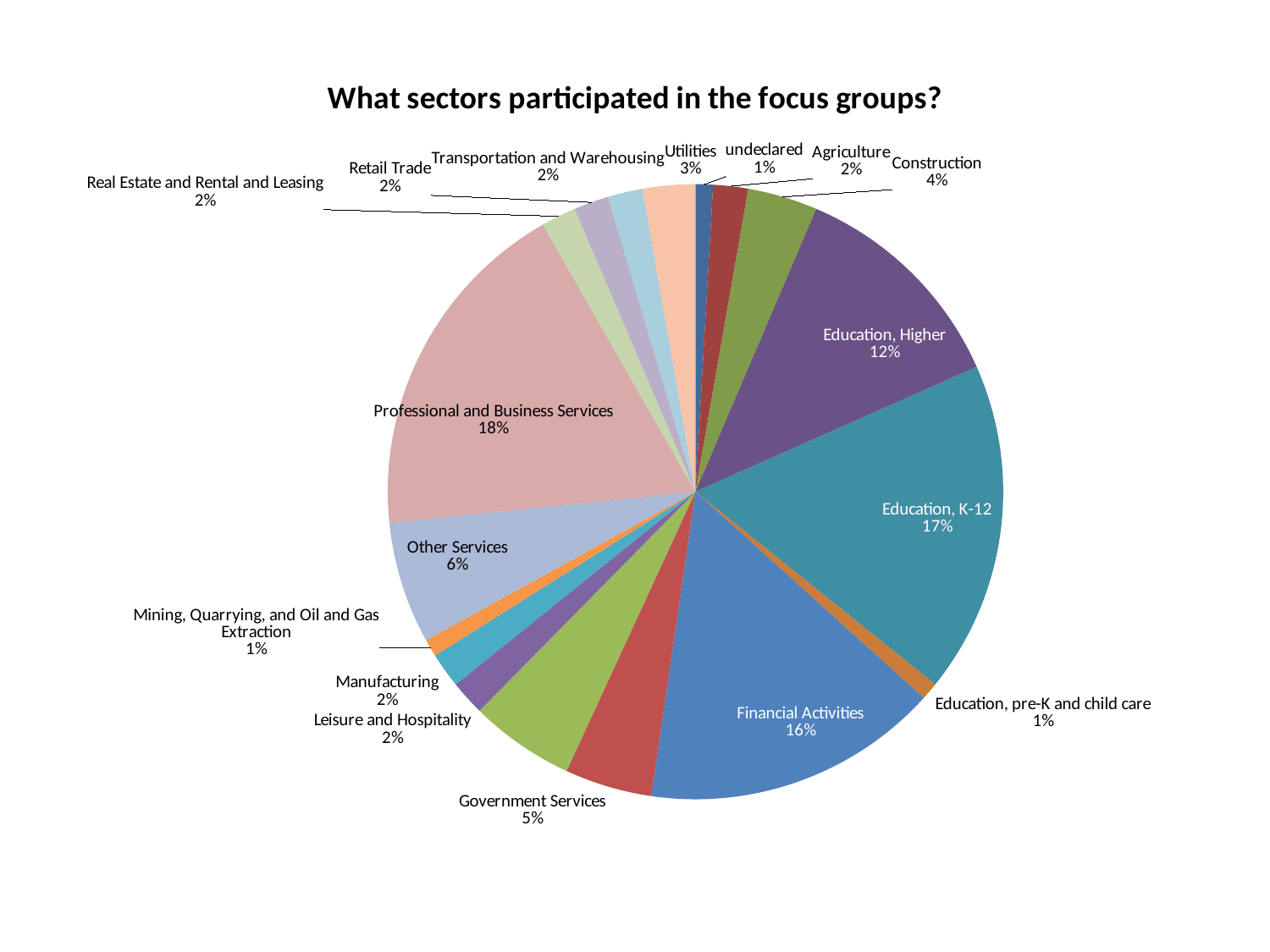
What percentage is shown for Financial Activities? 16% How many sectors (slices) are shown in the pie chart? 18 What percentage is shown for Education, Higher? 12% What share of the pie is Professional and Business Services? 18% What kind of chart is shown on the slide? pie chart What is the title of the chart? What sectors participated in the focus groups? What is the difference in percentage points between Professional and Business Services and Financial Activities? 2 What percentage is shown for Other Services? 6% What percentage is shown for Government Services? 5% Which is larger, the share for Education, K-12 or the share for Education, Higher? Education, K-12 What share of the pie is Education, K-12? 17% Which sector has the largest share of the pie? Professional and Business Services